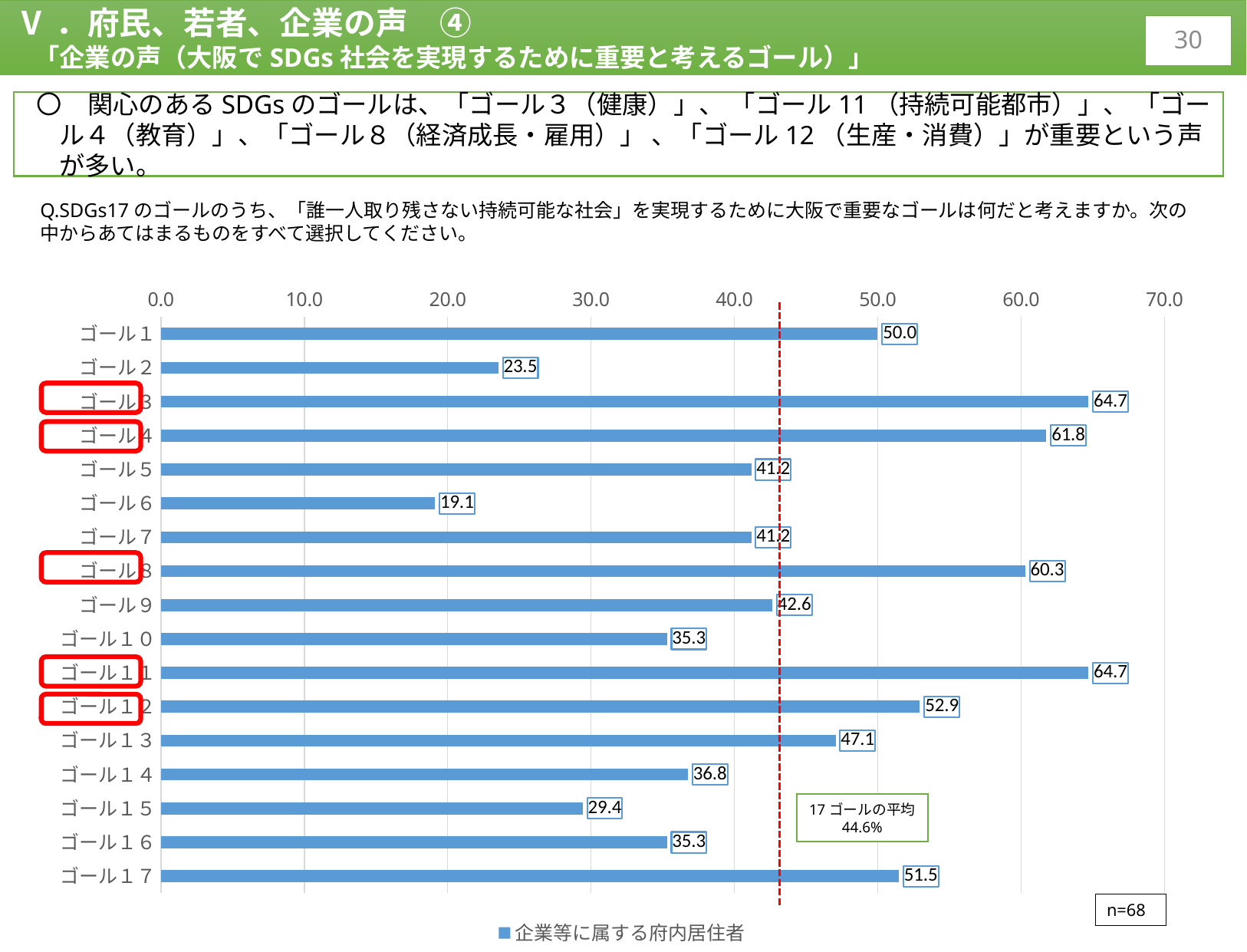
What is the difference between the values for ゴール１ and ゴール２? 26.5 What is the value for ゴール６? 19.1 Which is larger, the value for ゴール１３ or the value for ゴール１４? ゴール１３ Is the value for ゴール１５ greater or less than 30.0? less What is the value for ゴール１７? 51.5 What is the value for ゴール１２? 52.9 What kind of chart is shown on the slide? bar chart How many goals (categories) are plotted in the chart? 17 What is the difference between the values for ゴール４ and ゴール８? 1.5 Which goal has the lowest value? ゴール６ What average value for the 17 goals is noted on the chart? 44.6% What is the value for ゴール３? 64.7